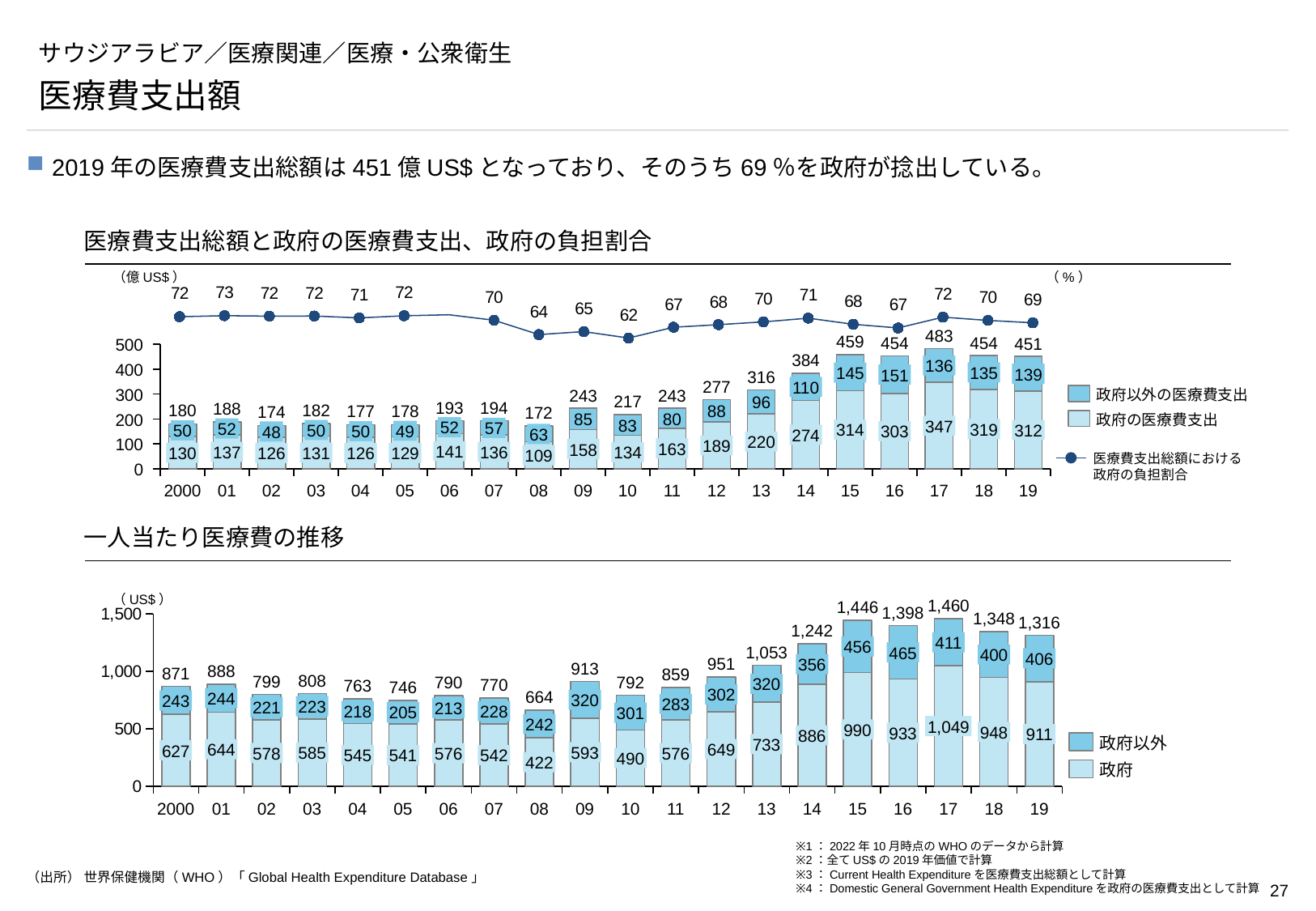
In the top chart (医療費支出総額と政府の医療費支出、政府の負担割合), what is the total health expenditure (bar total) for 19? 451 In the bottom chart (一人当たり医療費の推移), which year has the highest per-capita health expenditure total? 17 In the top chart, which year has the lowest total health expenditure? 08 In the bottom chart, which is larger, the 政府以外 value for 15 or for 16? 16 In the bottom chart, which year has the lowest per-capita health expenditure total? 08 In the top chart, which year has the highest total health expenditure? 17 In the top chart, what is the government share (政府の負担割合) shown on the line for 10? 62 In the top chart, which year has the lowest government share on the line? 10 In the bottom chart, what is the government (政府) per-capita value for 15? 990 What kind of chart is the bottom chart (一人当たり医療費の推移)? Stacked bar chart In the top chart, how many series does the legend list? 3 In the top chart, how much larger is the government health expenditure (政府の医療費支出) in 19 than in 2000? 182